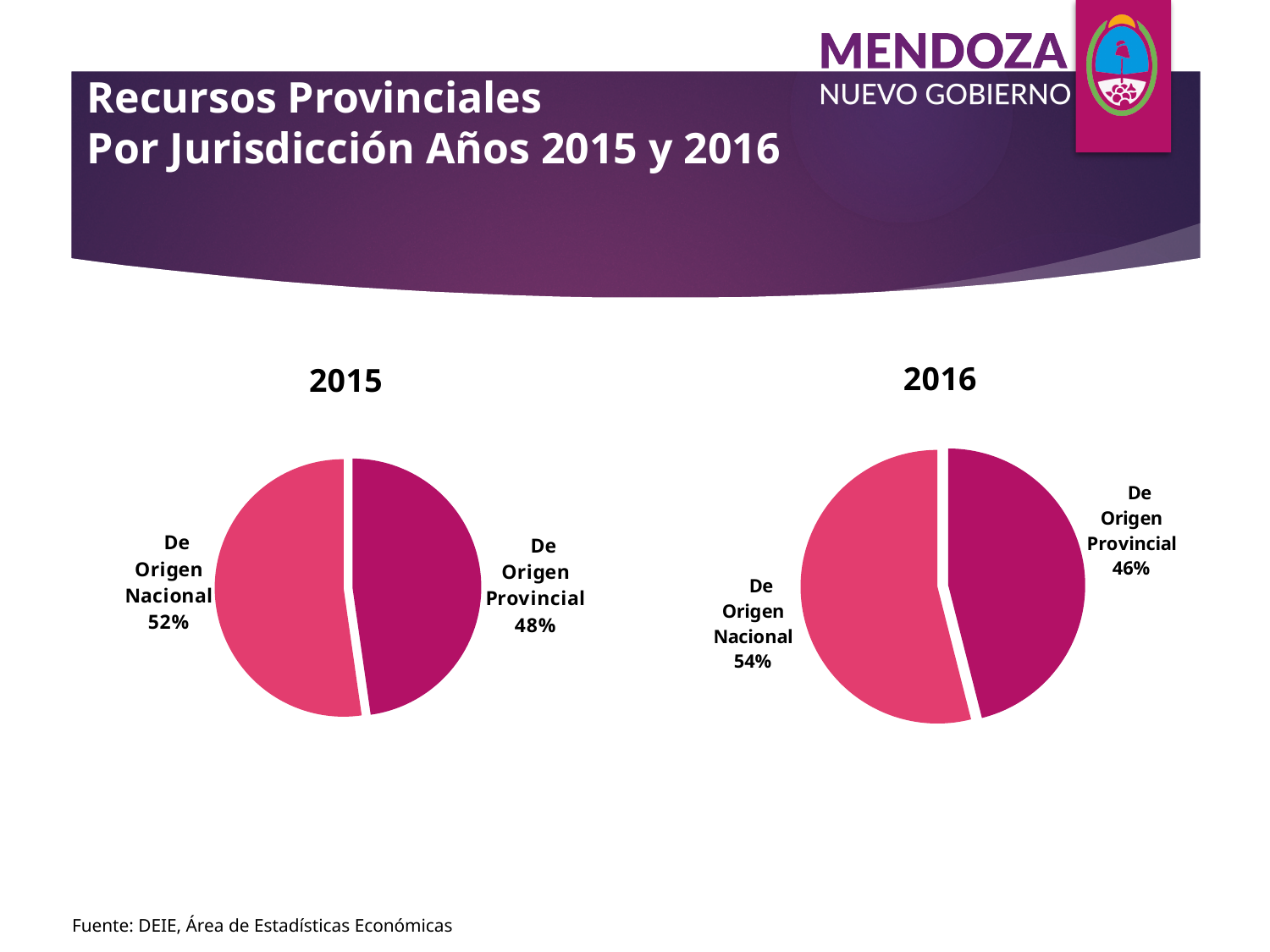
Which is larger: De Origen Provincial in the 2015 chart or De Origen Provincial in the 2016 chart? 2015 In the 2015 chart, which slice is the smallest? De Origen Provincial What kind of chart is the 2015 chart? Pie chart In the 2016 chart, what share is De Origen Provincial? 46% In the 2016 chart, which slice is the largest? De Origen Nacional How many slices does the 2016 chart have? 2 In the 2016 chart, what share is De Origen Nacional? 54% In the 2015 chart, what share is De Origen Provincial? 48% What is the title of the chart on the right? 2016 In the 2015 chart, what share is De Origen Nacional? 52% In the 2016 chart, what is the difference between the De Origen Nacional and De Origen Provincial shares? 8% In the 2015 chart, what is the difference between the De Origen Nacional and De Origen Provincial shares? 4%